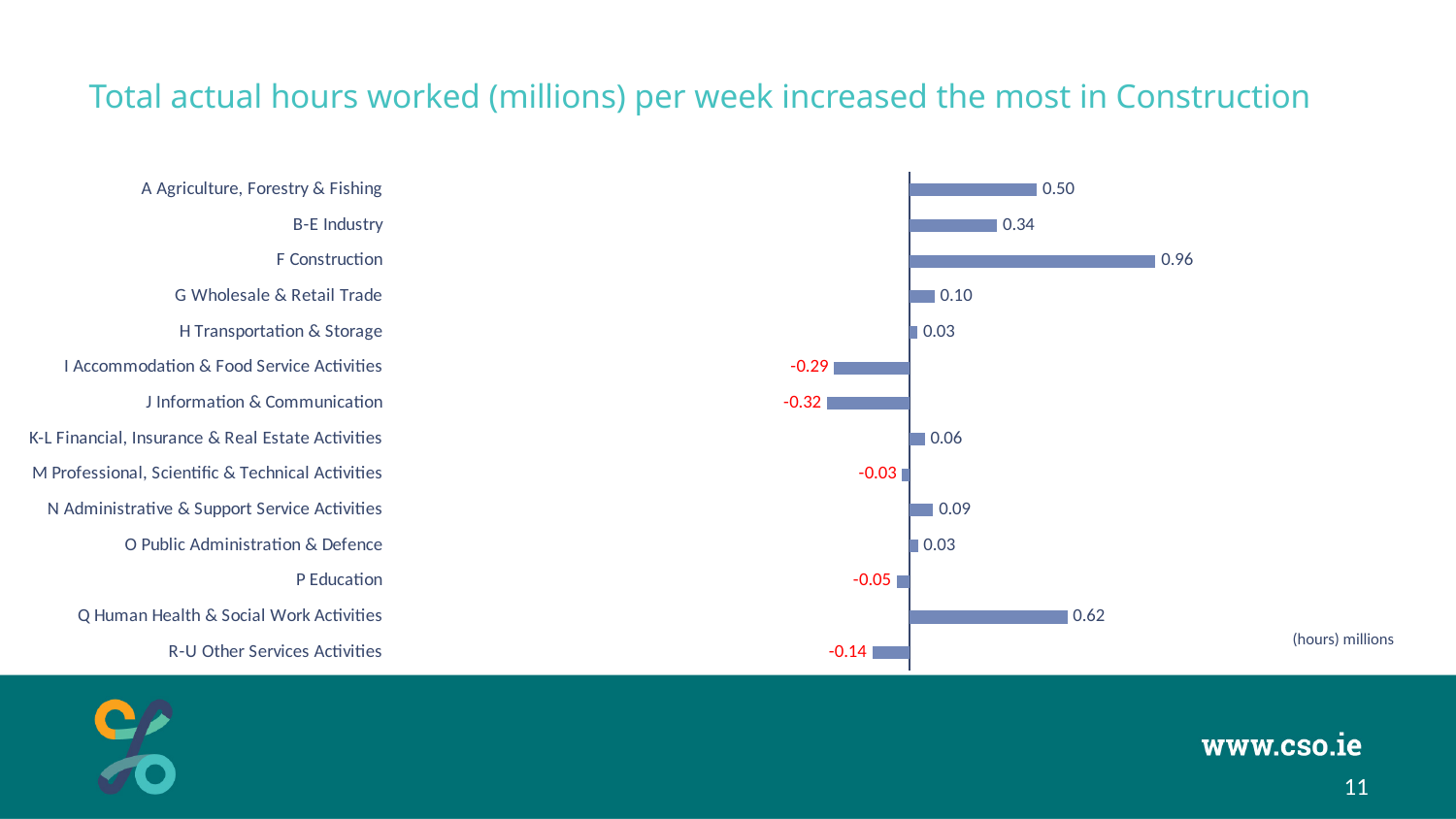
What is the value for J Information & Communication? -0.32 How many categories are shown in the chart? 14 What is the difference between the values for F Construction and Q Human Health & Social Work Activities? 0.34 What is the title of the chart? Total actual hours worked (millions) per week increased the most in Construction What is the value for F Construction? 0.96 Which category has the lowest value? J Information & Communication What unit is indicated at the bottom right of the chart? (hours) millions What is the value for Q Human Health & Social Work Activities? 0.62 What is the value for R-U Other Services Activities? -0.14 What kind of chart is shown on the slide? Bar chart Which category has the highest value? F Construction Which is larger, the value for A Agriculture, Forestry & Fishing or the value for B-E Industry? A Agriculture, Forestry & Fishing